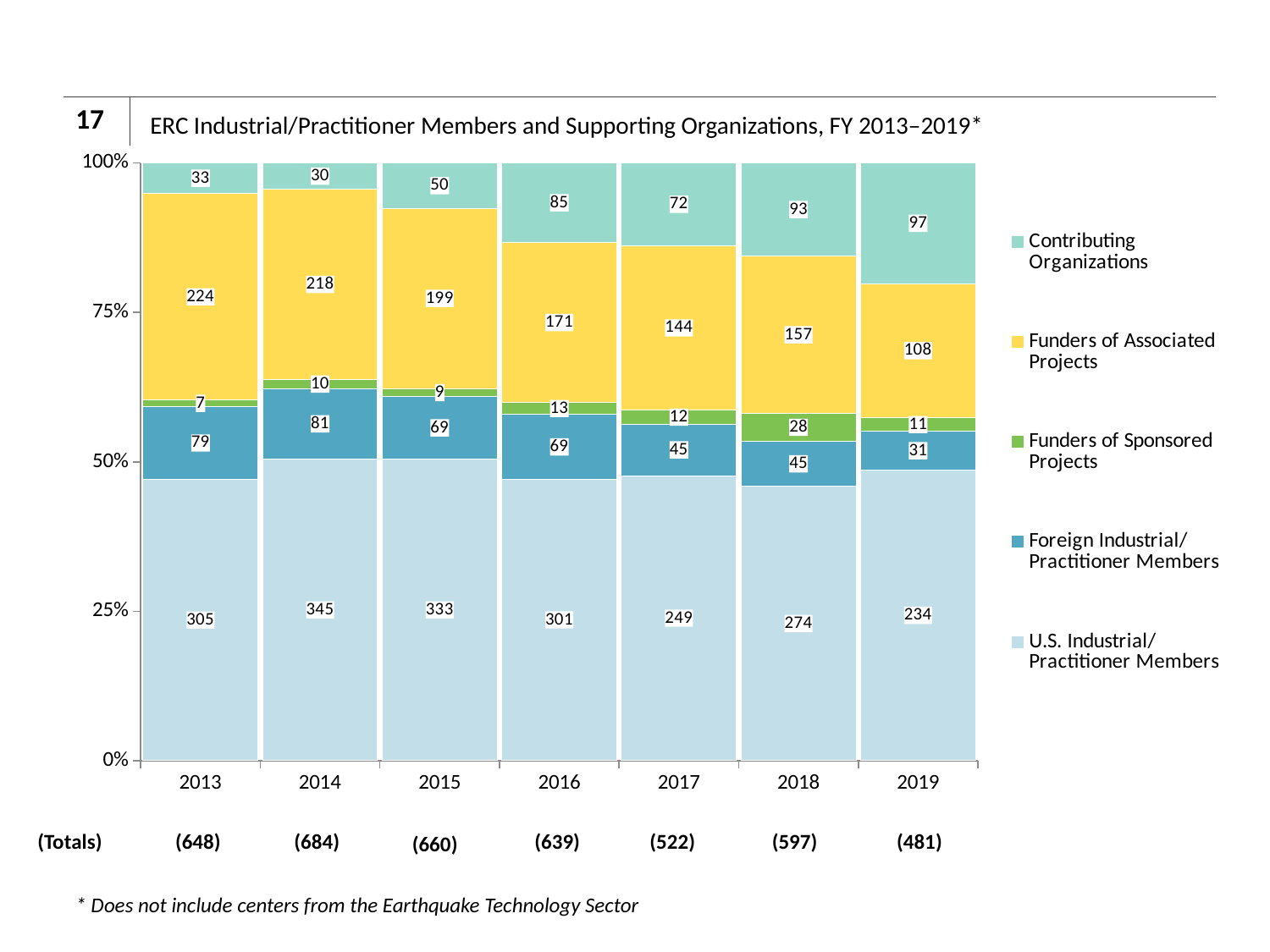
How many Contributing Organizations are shown for 2018? 93 How many U.S. Industrial/Practitioner Members were there in FY 2014? 345 What is the value for Funders of Associated Projects in 2019? 108 In which year is the U.S. Industrial/Practitioner Members value lowest? 2019 What is the total shown for the 2016 bar? 639 Do the Contributing Organizations values generally rise or fall from 2013 to 2019? Rise What kind of chart is shown on the slide? Stacked bar chart How many fiscal years are shown on the x axis? 7 What is the difference between the Funders of Associated Projects values in 2013 and 2017? 80 How many series does the legend list? 5 Which is larger: Foreign Industrial/Practitioner Members in 2014 or in 2019? 2014 In which year is the Funders of Sponsored Projects value highest? 2018